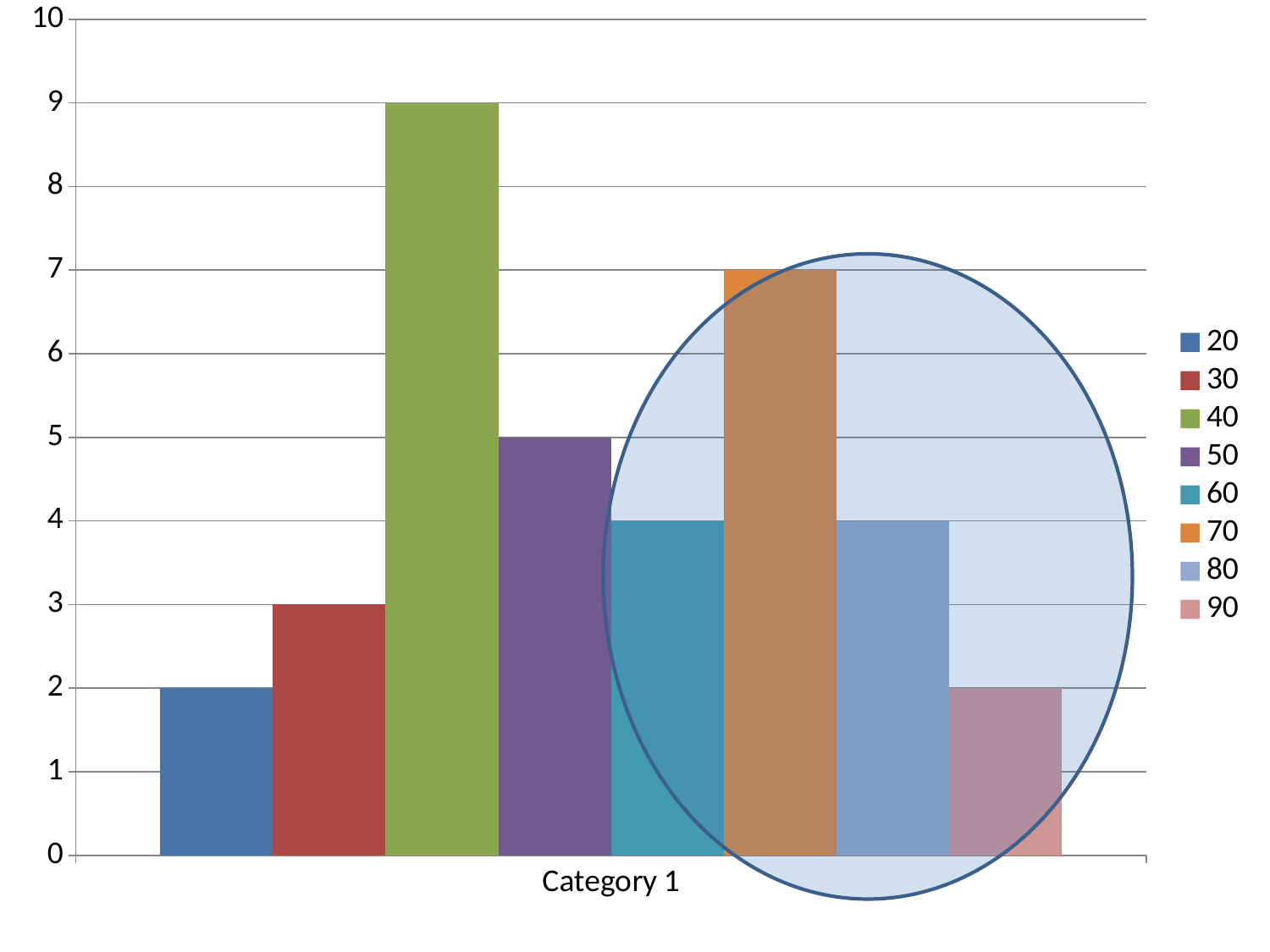
What is the difference between the values of series 40 and series 50? 4 Which is larger for Category 1, the value of series 30 or the value of series 60? 60 Which series has the highest value for Category 1? 40 What kind of chart is shown on the slide? bar chart What is the label of the single category on the x axis? Category 1 How many categories are shown on the x axis? 1 What is the value of the series labelled 70 for Category 1? 7 Which series are enclosed by the ellipse drawn over the chart? 60, 70, 80, 90 What is the value of the series labelled 50 for Category 1? 5 How many series does the legend list? 8 What is the value of the series labelled 40 for Category 1? 9 Is the value for series 70 greater or less than 6? greater